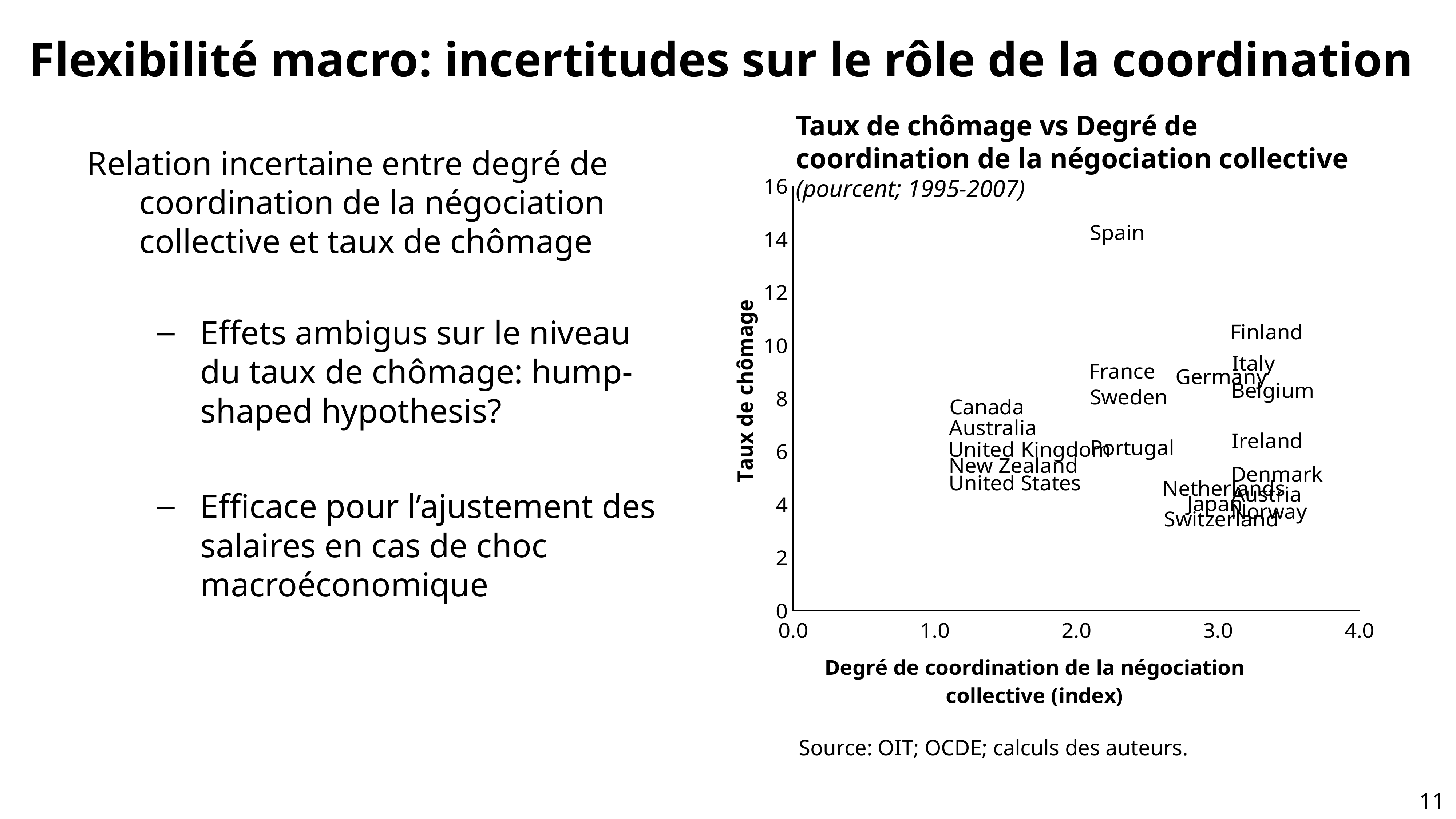
Is the unemployment rate for Ireland greater or less than 4? greater Is the unemployment rate for Finland greater or less than 8? greater What kind of chart is shown on the slide? Scatter chart Which country has the highest unemployment rate (Taux de chômage) in the chart? Spain Which has the higher unemployment rate, Canada or United States? Canada What is the label of the vertical axis of the chart? Taux de chômage Is the unemployment rate for United States greater or less than 6? less What is the title of the chart? Taux de chômage vs Degré de coordination de la négociation collective How many countries are plotted in the chart? 20 Which has the higher unemployment rate, Spain or Finland? Spain